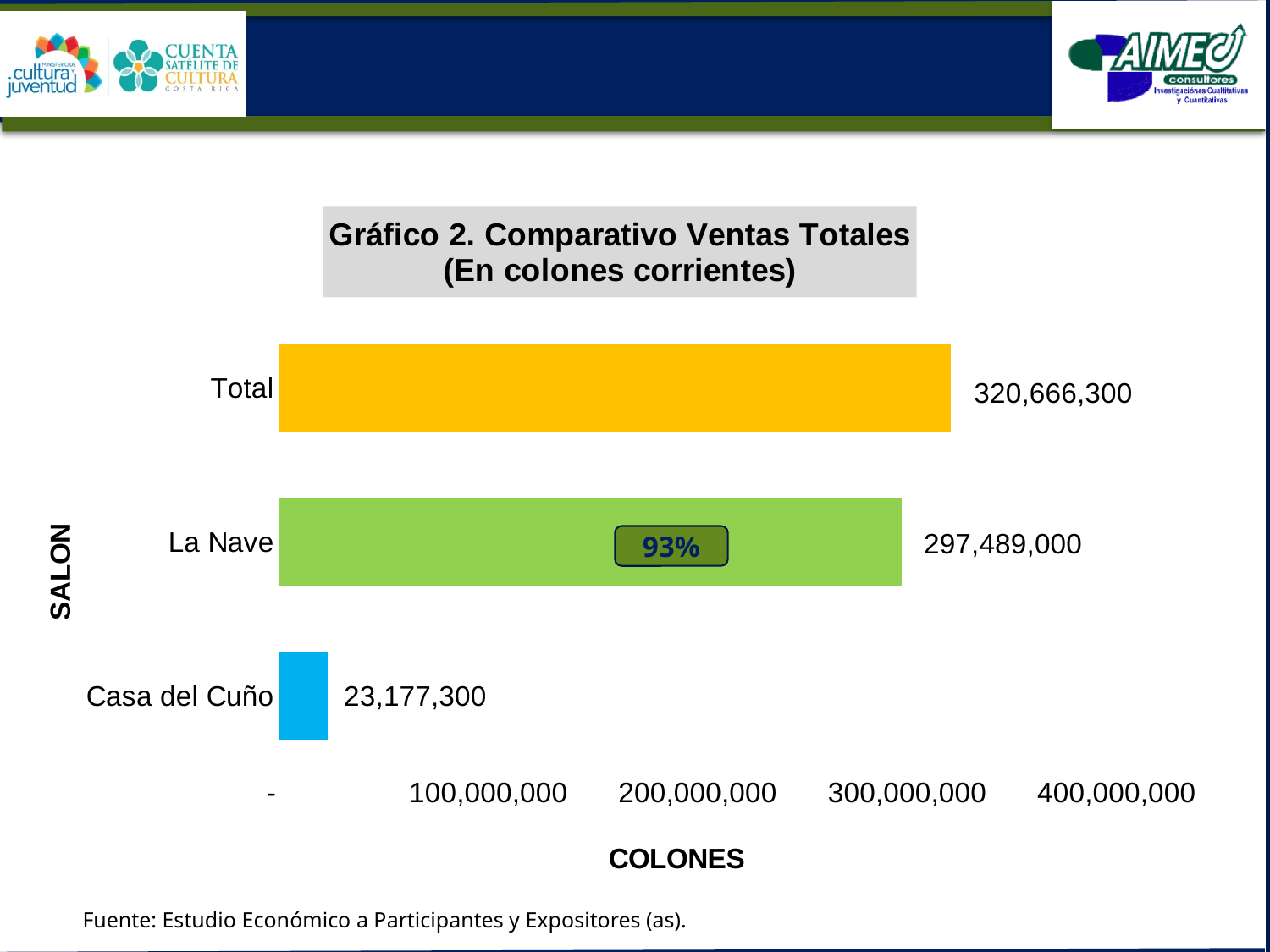
Is the value for La Nave greater or less than 200,000,000? greater What is the difference between the values for Total and La Nave? 23,177,300 How many categories are shown on the chart? 3 What is the value for La Nave? 297,489,000 What is the difference between the values for La Nave and Casa del Cuño? 274,311,700 What is the value for Casa del Cuño? 23,177,300 Which category has the lowest value? Casa del Cuño What is the value for Total? 320,666,300 Which is larger, the value for La Nave or the value for Casa del Cuño? La Nave Which category has the highest value? Total What percentage label is shown on the La Nave bar? 93% What kind of chart is shown on the slide? bar chart